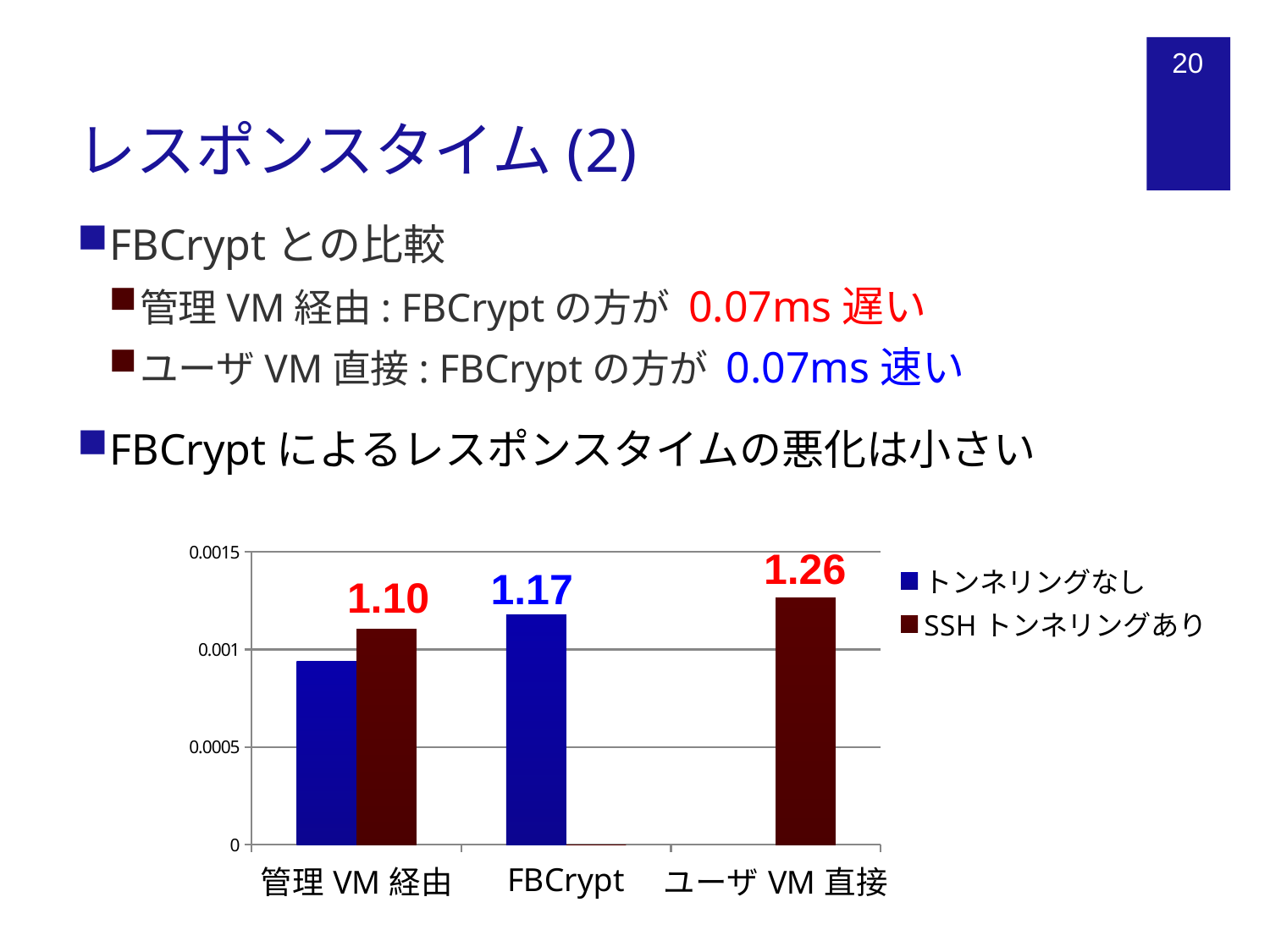
What is the difference between the labelled value for ユーザ VM 直接 (1.26) and the labelled value for 管理 VM 経由 (1.10)? 0.16 Which of the three labelled values in the chart is the lowest? 1.10 What is the labelled value of the トンネリングなし bar for FBCrypt? 1.17 How many series does the chart's legend list? 2 What colour represents the トンネリングなし series in the chart? blue What kind of chart is shown on the slide? bar chart What is the labelled value of the SSH トンネリングあり bar for ユーザ VM 直接? 1.26 How many categories are shown on the x axis of the chart? 3 Is the value of the トンネリングなし bar for 管理 VM 経由 greater or less than 0.001? less Which is larger: the labelled value for FBCrypt or the labelled value for 管理 VM 経由? FBCrypt Which category has the tallest bar in the chart? ユーザ VM 直接 What is the labelled value of the SSH トンネリングあり bar for 管理 VM 経由? 1.10